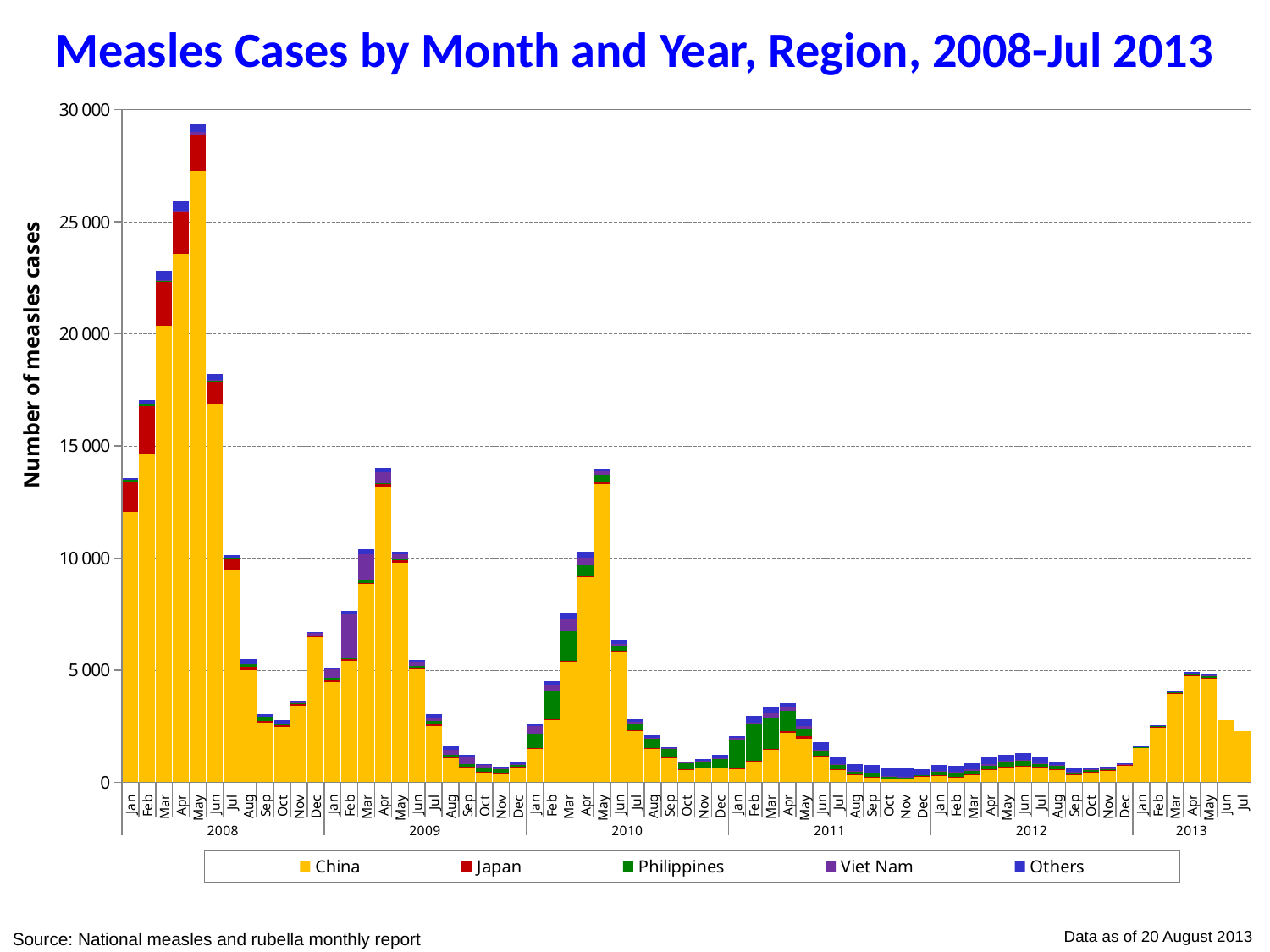
How many series does the legend list? 5 How many year groups are labelled along the x axis? 6 Which month has the highest total number of measles cases? May 2008 What kind of chart is shown on the slide? Stacked bar chart Do the monthly totals rise or fall from Jan 2008 to May 2008? rise What is the label of the y axis? Number of measles cases Is the total for May 2008 greater or less than 25 000? greater Is the total for Oct 2011 greater or less than 5 000? less Which series is shown in yellow in the legend? China Is the total for Apr 2009 greater or less than 10 000? greater Which has the larger total, May 2008 or May 2009? May 2008